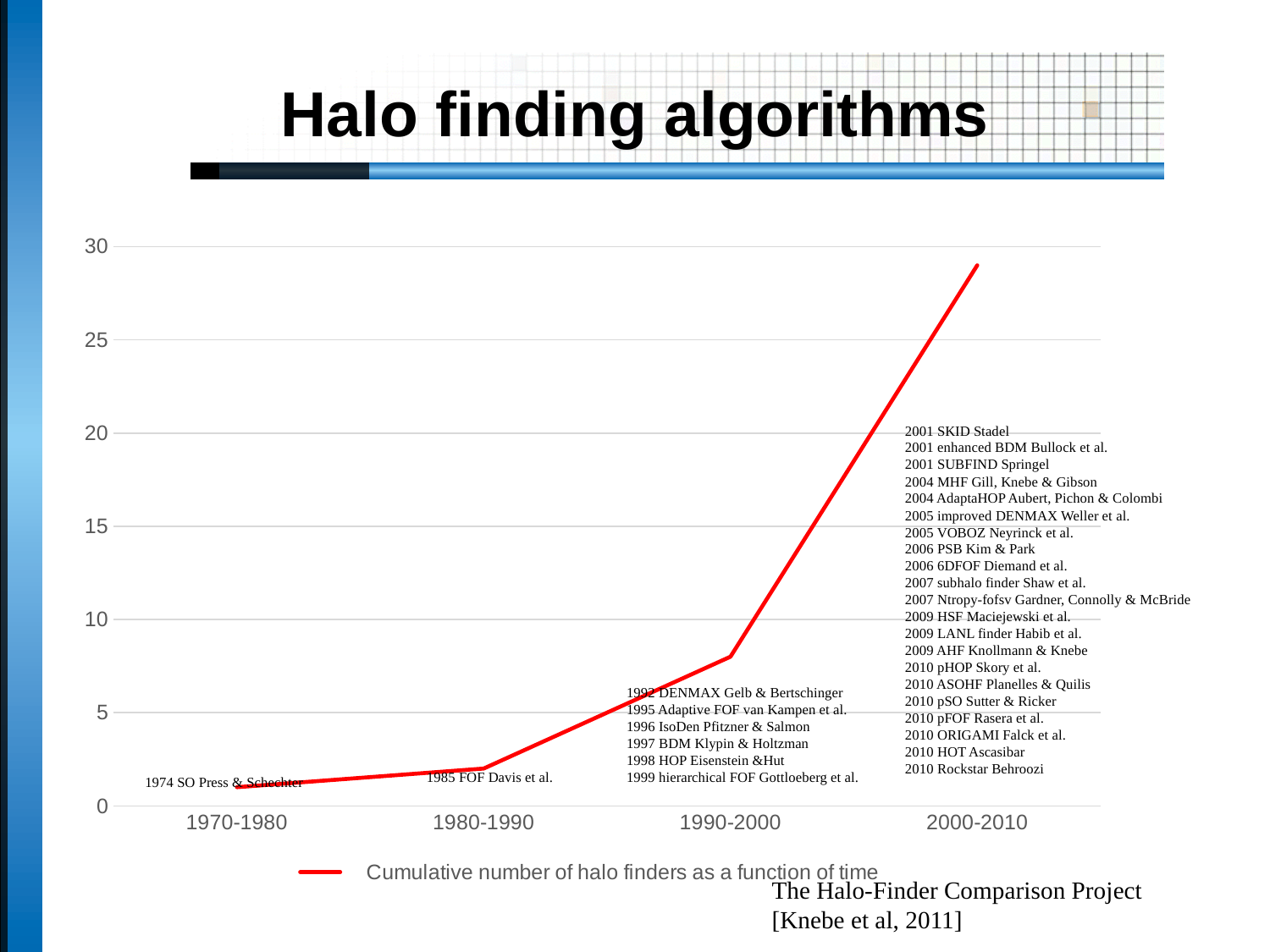
Is the value for 2000-2010 greater or less than 25? greater Which time period has the highest cumulative number of halo finders? 2000-2010 Is the value for 1990-2000 greater or less than 5? greater What is the legend entry for the red line in the chart? Cumulative number of halo finders as a function of time Is the value for 1970-1980 greater or less than 5? less How many series does the chart's legend list? 1 What kind of chart is shown on the slide? line chart How many time periods are shown on the x axis of the chart? 4 Which is larger, the value for 1990-2000 or the value for 2000-2010? 2000-2010 Do the values rise or fall along the x axis from 1970-1980 to 2000-2010? rise